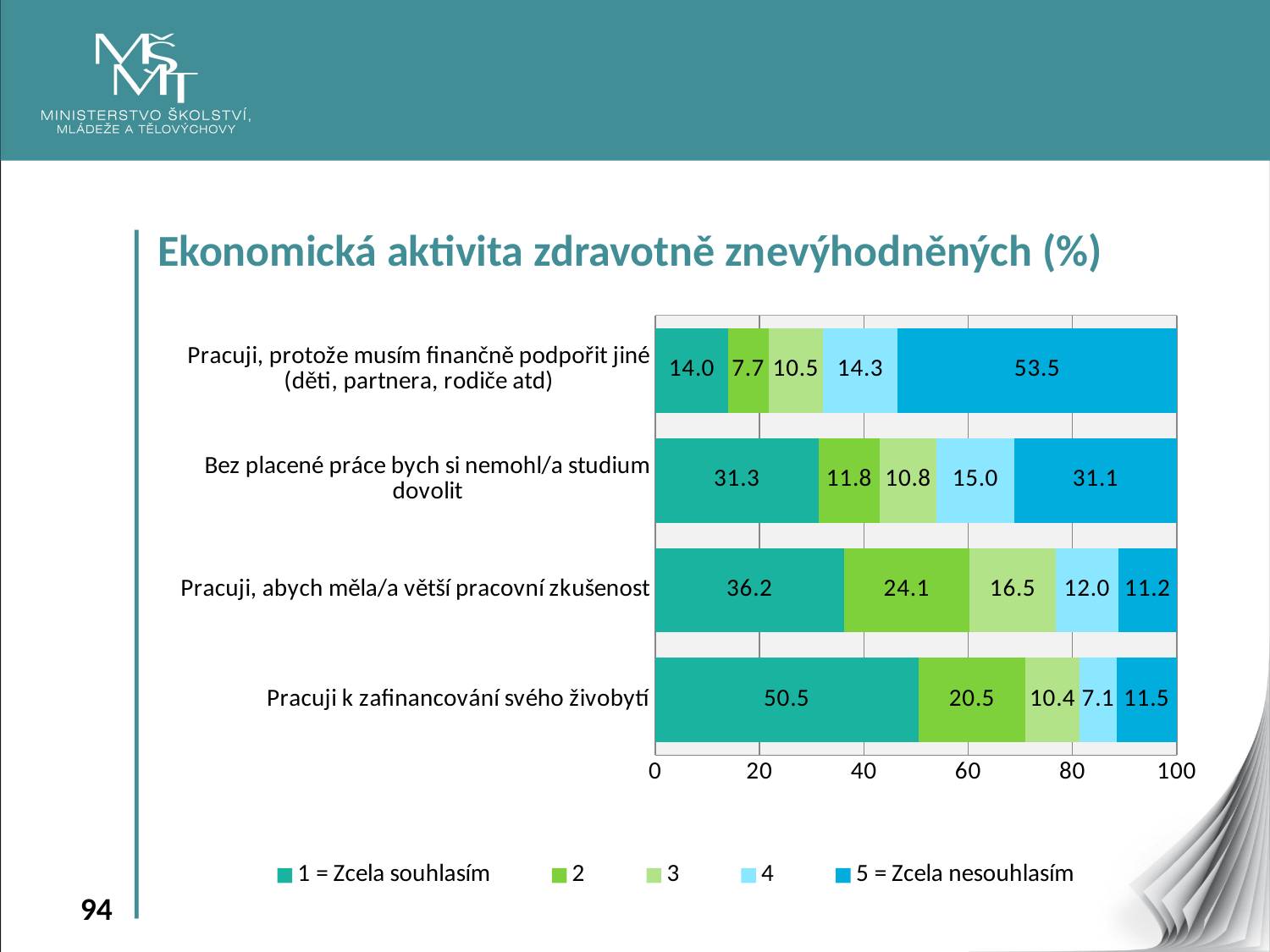
What is the title of the chart? Ekonomická aktivita zdravotně znevýhodněných (%) How many categories (statements) are plotted in the chart? 4 For "Pracuji, protože musím finančně podpořit jiné (děti, partnera, rodiče atd)", what is the difference between the "5 = Zcela nesouhlasím" value and the "1 = Zcela souhlasím" value? 39.5 How many series does the legend list? 5 What is the value of "5 = Zcela nesouhlasím" for "Pracuji, protože musím finančně podpořit jiné (děti, partnera, rodiče atd)"? 53.5 Which has a larger value for series "2": "Pracuji, abych měla/a větší pracovní zkušenost" or "Pracuji k zafinancování svého živobytí"? Pracuji, abych měla/a větší pracovní zkušenost Which category has the lowest value for "1 = Zcela souhlasím"? Pracuji, protože musím finančně podpořit jiné (děti, partnera, rodiče atd) What is the value of "1 = Zcela souhlasím" for "Pracuji k zafinancování svého živobytí"? 50.5 What is the total of the stacked bar for "Pracuji, abych měla/a větší pracovní zkušenost"? 100.0 What kind of chart is shown on the slide? Stacked bar chart What is the value of series "4" for "Bez placené práce bych si nemohl/a studium dovolit"? 15.0 Which category has the highest value for "1 = Zcela souhlasím"? Pracuji k zafinancování svého živobytí